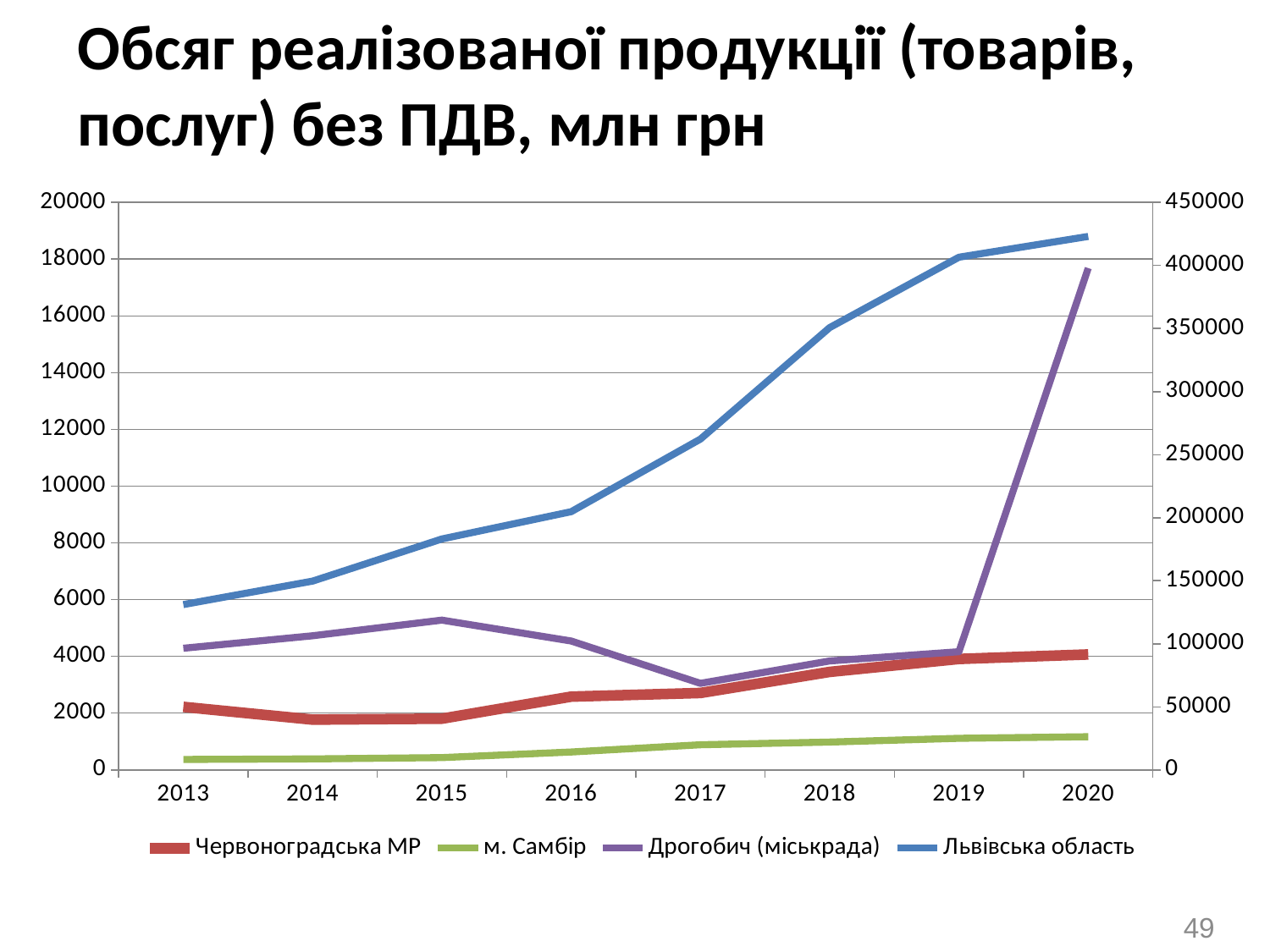
What colour is the line for Львівська область? blue In 2015, which is larger: the value for Дрогобич (міськрада) or for Червоноградська МР? Дрогобич (міськрада) How many series does the legend list? 4 In which year is the value for Дрогобич (міськрада) lowest? 2017 What kind of chart is shown on the slide? line chart Is the value for Червоноградська МР in 2018 greater or less than 3000 on the left axis? greater Does the value for м. Самбір rise or fall from 2013 to 2020? rise Does the value for Львівська область rise or fall from 2013 to 2020? rise Is the value for Дрогобич (міськрада) in 2020 greater or less than 16000 on the left axis? greater Is the value for Львівська область in 2018 greater or less than 300000 on the right axis? greater In which year is the value for Дрогобич (міськрада) highest? 2020 How many years are shown on the x axis? 8